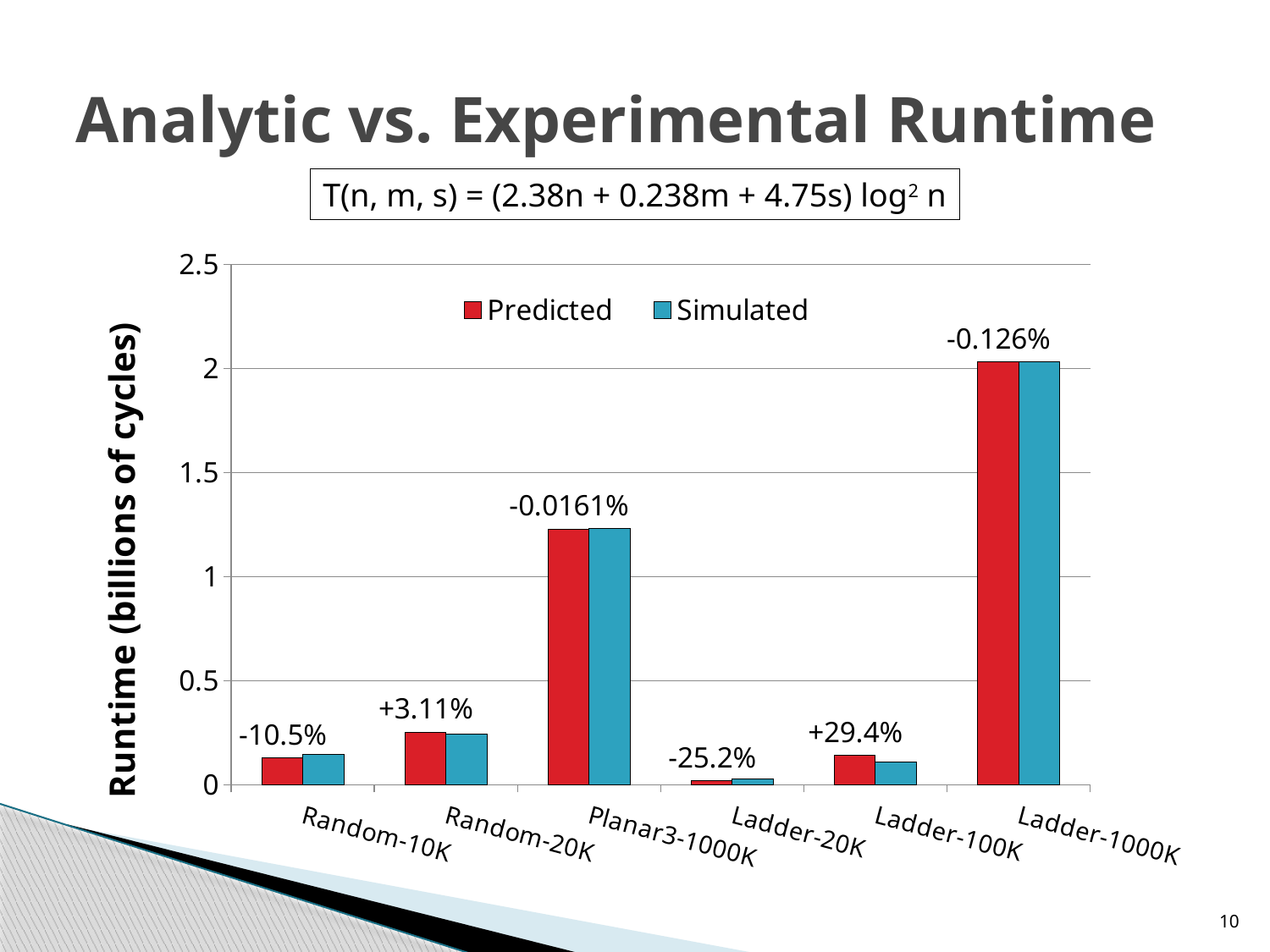
What kind of chart is shown on the slide? bar chart Is the Predicted runtime for Random-10K greater or less than 0.5? less How many categories are shown on the x axis? 6 What is the label of the y axis? Runtime (billions of cycles) What percentage label is printed above the Planar3-1000K bars? -0.0161% Which has a larger Simulated runtime, Planar3-1000K or Random-20K? Planar3-1000K How many series does the legend list? 2 Is the Simulated runtime for Planar3-1000K greater or less than 1.5? less What percentage label is printed above the Ladder-100K bars? +29.4% Is the Predicted runtime for Ladder-1000K greater or less than 2? greater Which category has the highest runtime? Ladder-1000K Which category has the lowest runtime? Ladder-20K